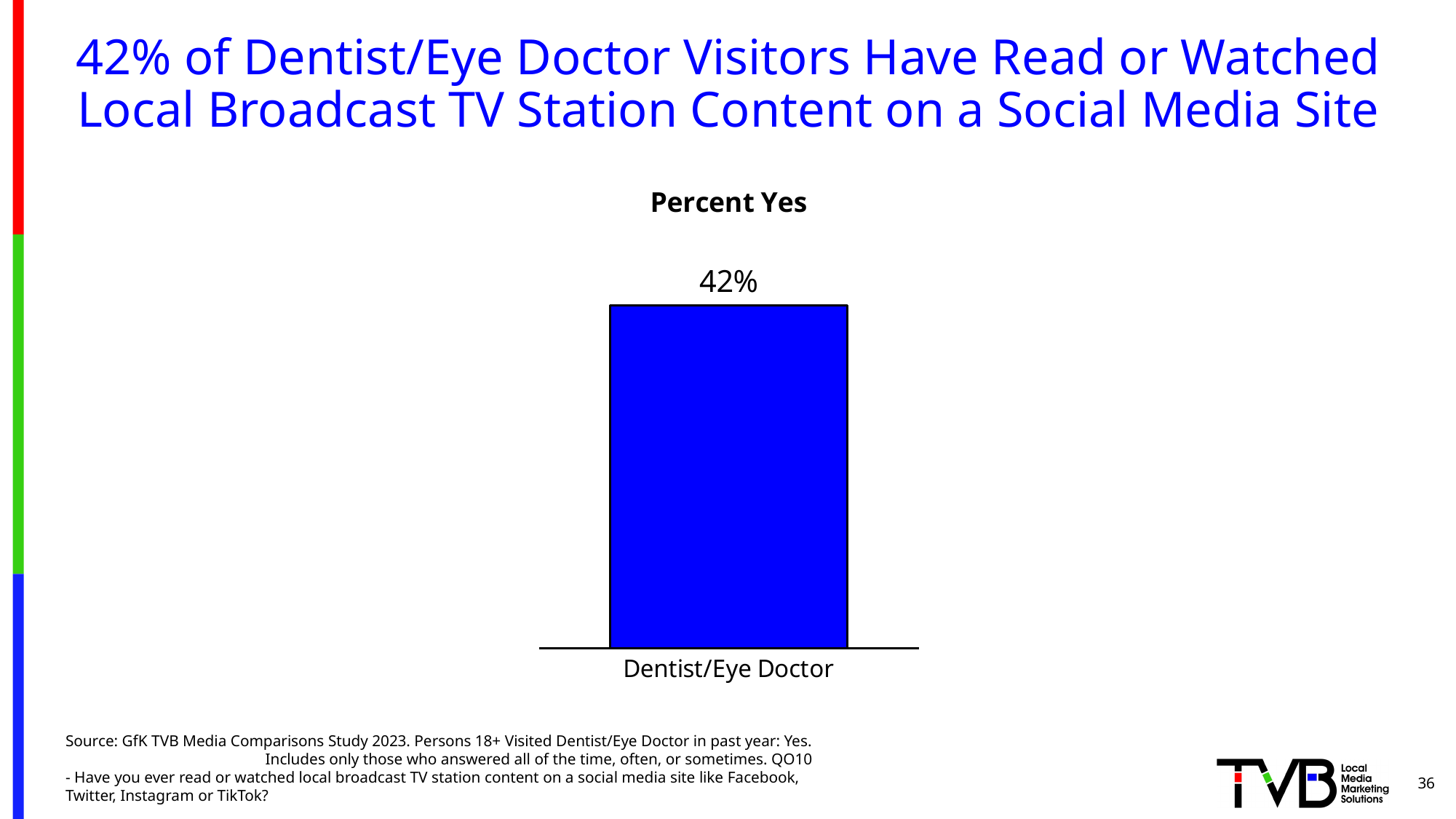
Is the value for Dentist/Eye Doctor greater or less than 50%? less Is the value for Dentist/Eye Doctor greater or less than 40%? greater What is the title of the chart? Percent Yes What is the value shown for Dentist/Eye Doctor in the chart? 42% How many bars does the chart contain? 1 What kind of chart is shown on the slide? bar chart What is the category label on the x axis of the chart? Dentist/Eye Doctor